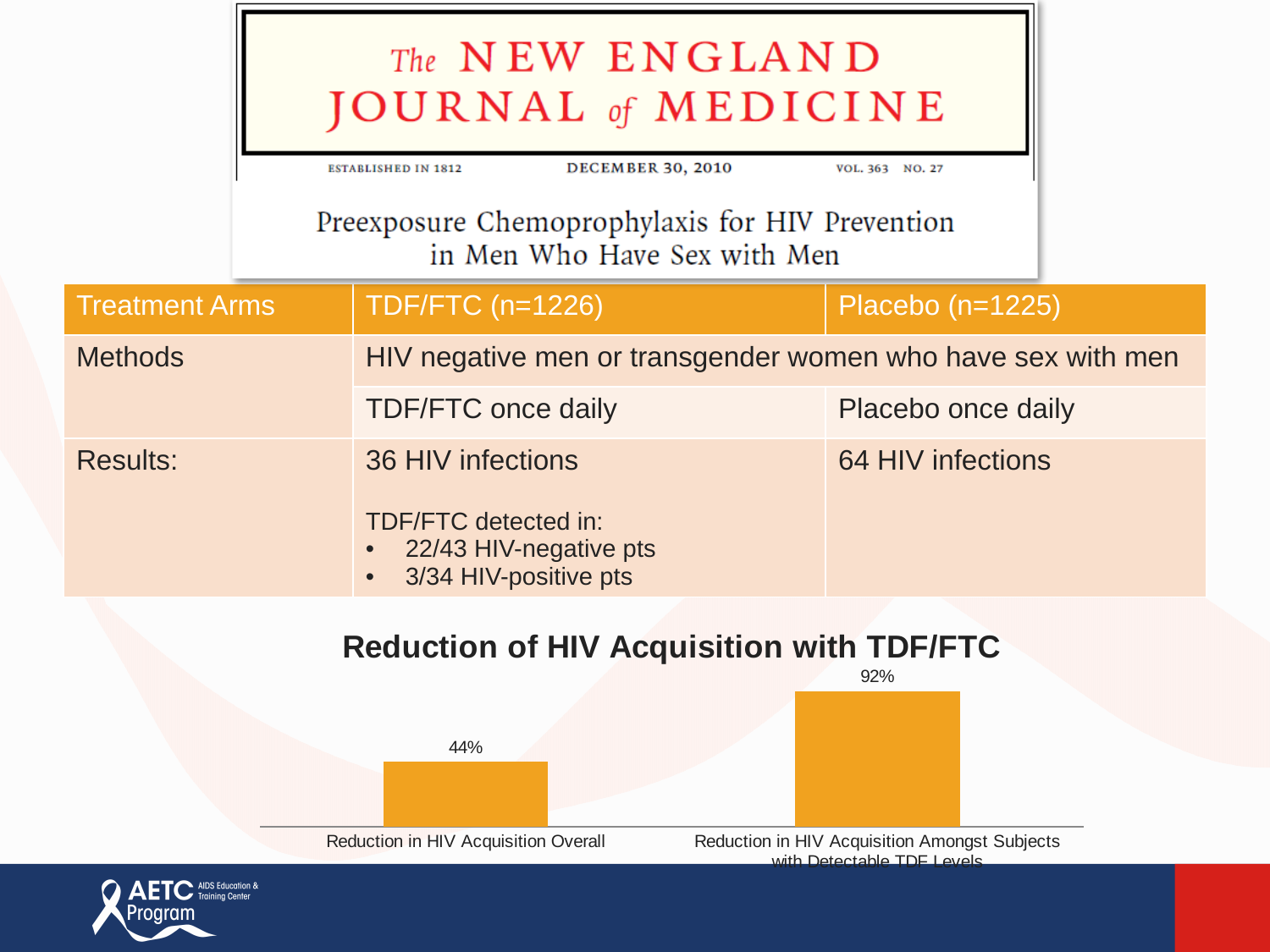
How many categories are shown in the chart? 2 What is the title of the chart? Reduction of HIV Acquisition with TDF/FTC Do the values rise or fall from left to right across the chart? Rise What kind of chart is shown on the slide? Bar chart What is the value for Reduction in HIV Acquisition Overall? 44% What is the difference between the reduction amongst subjects with detectable TDF levels and the overall reduction? 48% Which is larger: the overall reduction in HIV acquisition or the reduction amongst subjects with detectable TDF levels? Reduction in HIV Acquisition Amongst Subjects with Detectable TDF Levels Which category has the lowest value in the chart? Reduction in HIV Acquisition Overall What is the value for Reduction in HIV Acquisition Amongst Subjects with Detectable TDF Levels? 92% Which category has the highest value in the chart? Reduction in HIV Acquisition Amongst Subjects with Detectable TDF Levels What colour are the bars in the chart? Orange